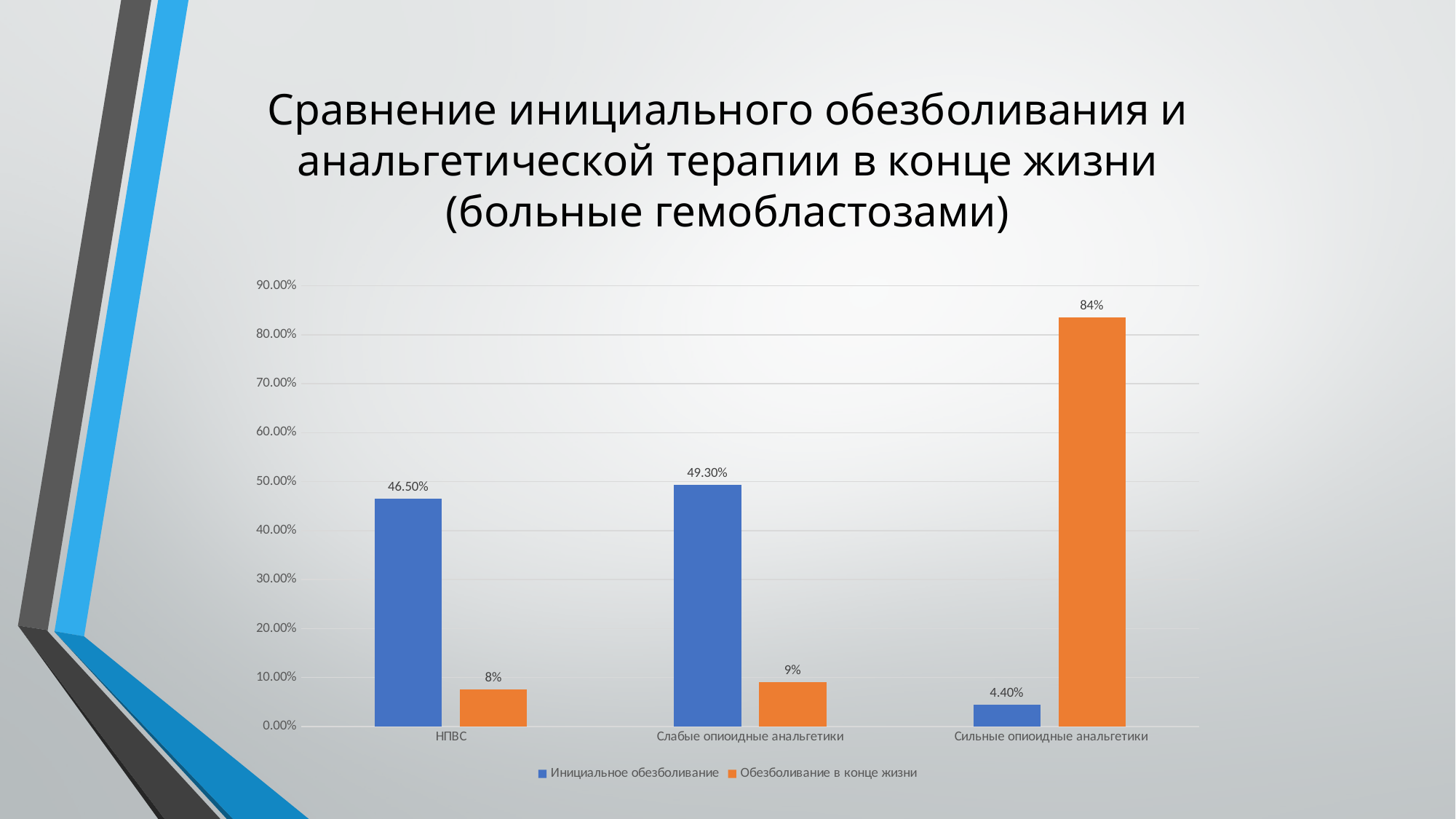
What colour are the bars for the Обезболивание в конце жизни series? Orange Which category has the lowest value in the Инициальное обезболивание series? Сильные опиоидные анальгетики What kind of chart is shown on the slide? Bar chart What is the difference between the Обезболивание в конце жизни values for Слабые опиоидные анальгетики and НПВС? 1% Which is larger for НПВС: Инициальное обезболивание or Обезболивание в конце жизни? Инициальное обезболивание Which category has the highest value in the Обезболивание в конце жизни series? Сильные опиоидные анальгетики What is the value for Сильные опиоидные анальгетики in the Обезболивание в конце жизни series? 84% What is the value for Слабые опиоидные анальгетики in the Инициальное обезболивание series? 49.30% How many series does the legend list? 2 How many categories are shown on the x axis? 3 What is the value for НПВС in the Инициальное обезболивание series? 46.50% What is the value for Сильные опиоидные анальгетики in the Инициальное обезболивание series? 4.40%